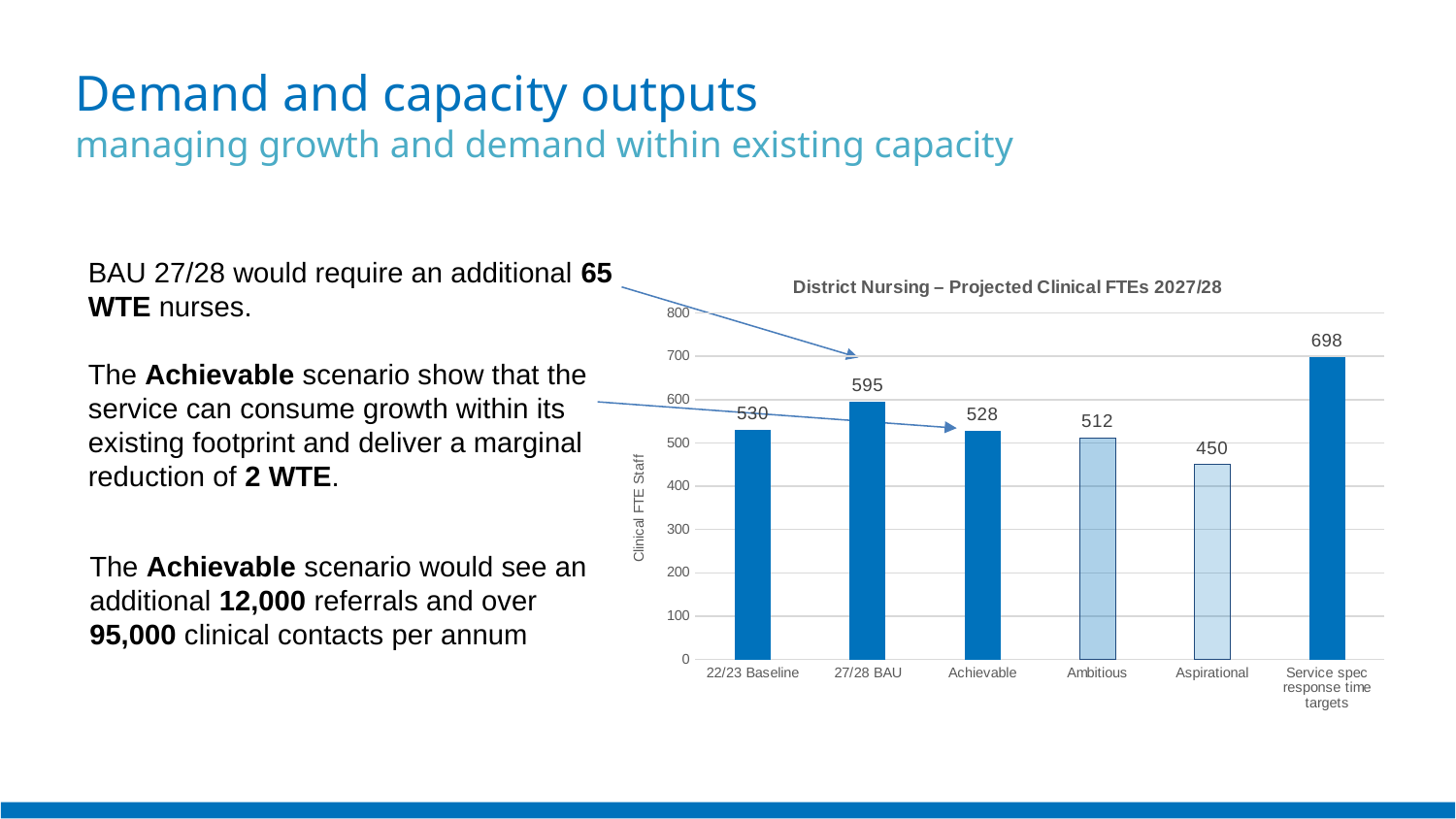
What kind of chart is shown? bar chart Is the value for Ambitious greater or less than 600? less Which category has the highest value? Service spec response time targets What is the title of the chart? District Nursing – Projected Clinical FTEs 2027/28 Which category has the lowest value? Aspirational What is the value for the Aspirational scenario? 450 What is the value for 27/28 BAU? 595 Which is larger, the value for 22/23 Baseline or the value for Ambitious? 22/23 Baseline What is the difference between 27/28 BAU and 22/23 Baseline? 65 How many categories are shown on the x axis? 6 What is the difference between the Achievable and Ambitious values? 16 What is the value for Service spec response time targets? 698